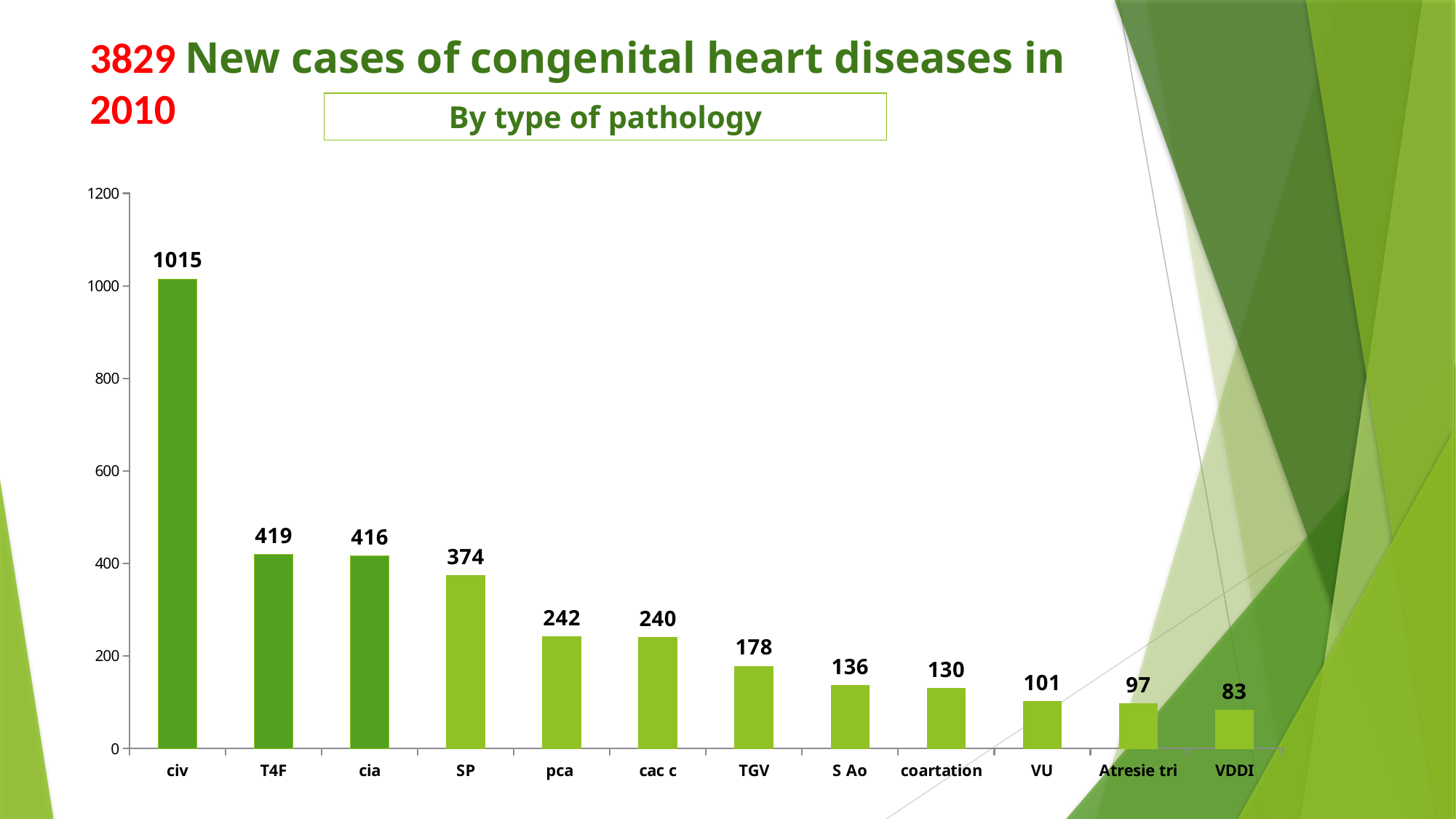
What is the difference between the values for SP and pca? 132 Which category has the highest value? civ What kind of chart is shown on the slide? bar chart Is the value for SP greater or less than 400? less What is the value for coartation? 130 How many categories are shown on the x axis? 12 What is the value for civ? 1015 What is the value for TGV? 178 Which category has the lowest value? VDDI Which is larger, the value for VU or the value for Atresie tri? VU Do the values rise or fall from left to right along the x axis? fall What is the difference between the values for civ and T4F? 596